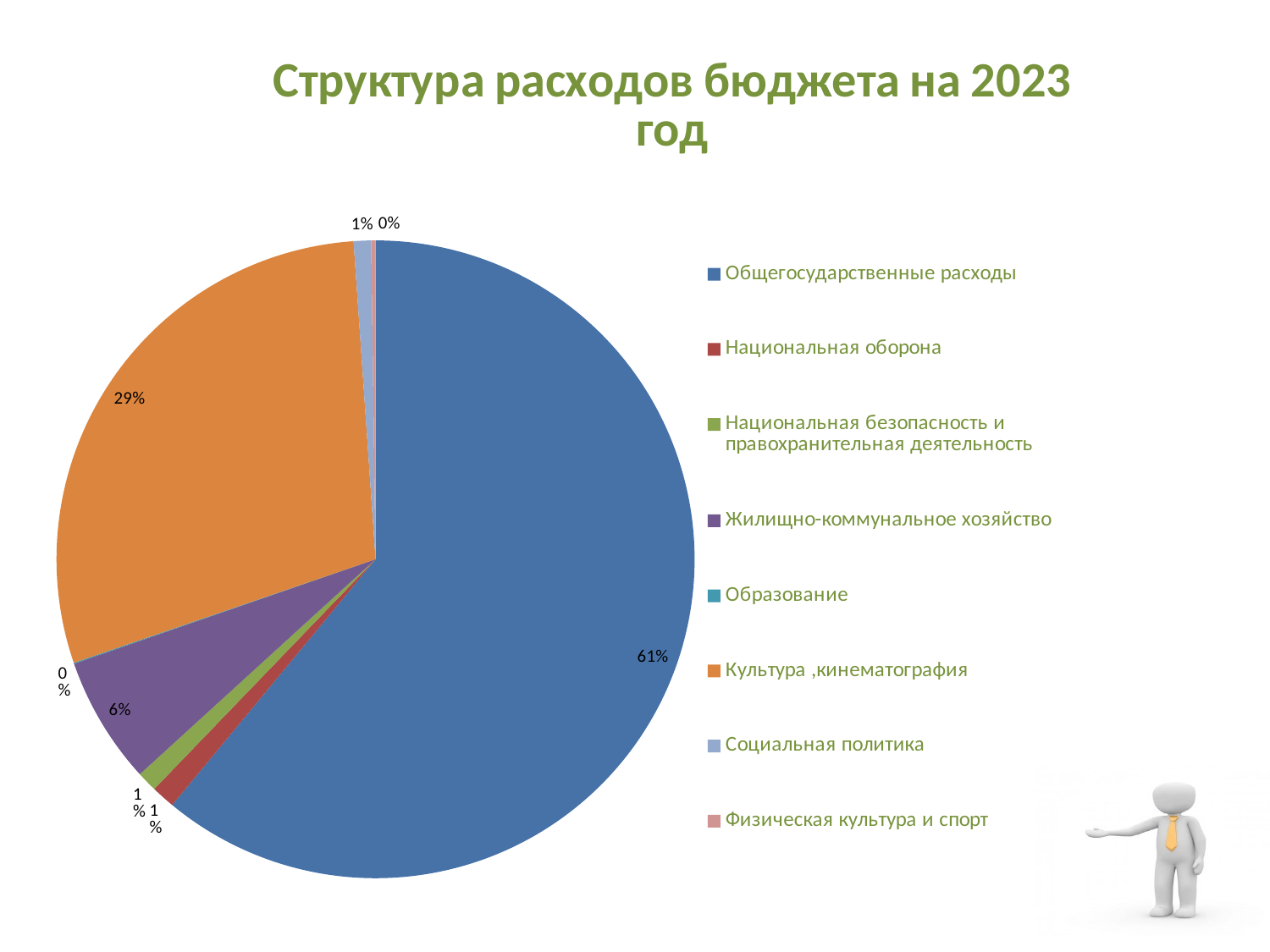
Which has a larger share: Жилищно-коммунальное хозяйство or Культура ,кинематография? Культура ,кинематография What share of the budget expenditure goes to Социальная политика? 1% What share of the budget expenditure goes to Культура ,кинематография? 29% What colour is the slice for Культура ,кинематография? orange What share of the budget expenditure goes to Жилищно-коммунальное хозяйство? 6% Which category has the largest share of the budget expenditure? Общегосударственные расходы What share of the budget expenditure goes to Общегосударственные расходы? 61% What is the title of the chart? Структура расходов бюджета на 2023 год What is the combined share of Общегосударственные расходы and Культура ,кинематография? 90% What kind of chart is shown on the slide? pie chart What is the difference in percentage points between Общегосударственные расходы and Культура ,кинематография? 32 How many categories does the legend list? 8